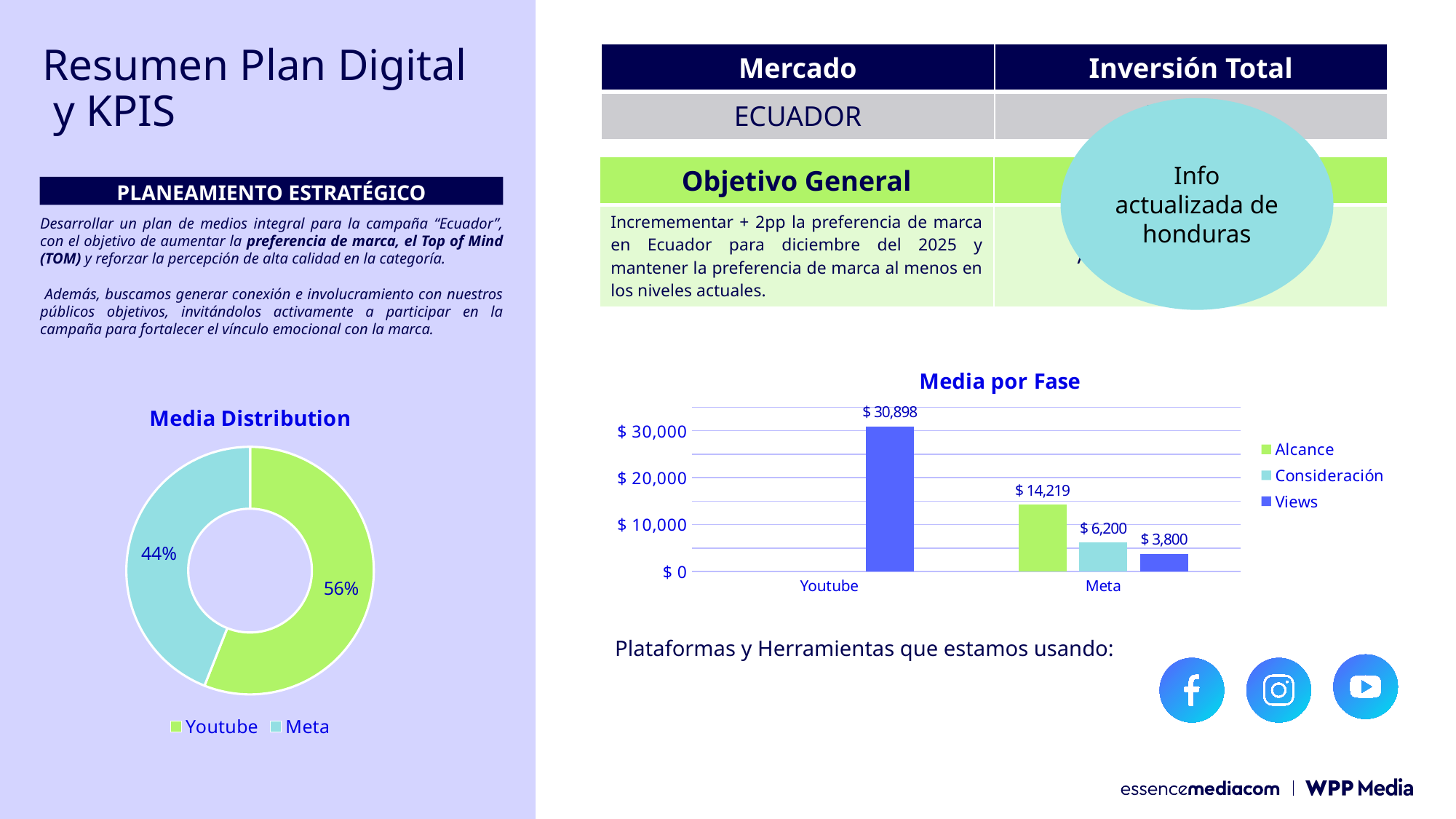
In the 'Media Distribution' chart, which platform has the larger share? Youtube In the 'Media por Fase' chart, what is the Views value for Youtube? $ 30,898 In the 'Media por Fase' chart, what is the Views value for Meta? $ 3,800 In the 'Media por Fase' chart, what is the Alcance value for Meta? $ 14,219 In the 'Media por Fase' chart, which bar is the lowest? Meta Views In the 'Media Distribution' chart, what share does Youtube have? 56% How many series does the legend of the 'Media por Fase' chart list? 3 In the 'Media por Fase' chart, what is the difference between the Views value for Youtube and the Views value for Meta? $ 27,098 In the 'Media Distribution' chart, what share does Meta have? 44% What kind of chart is 'Media por Fase'? Bar chart In the 'Media por Fase' chart, what is the Consideración value for Meta? $ 6,200 What kind of chart is 'Media Distribution'? Pie (donut) chart